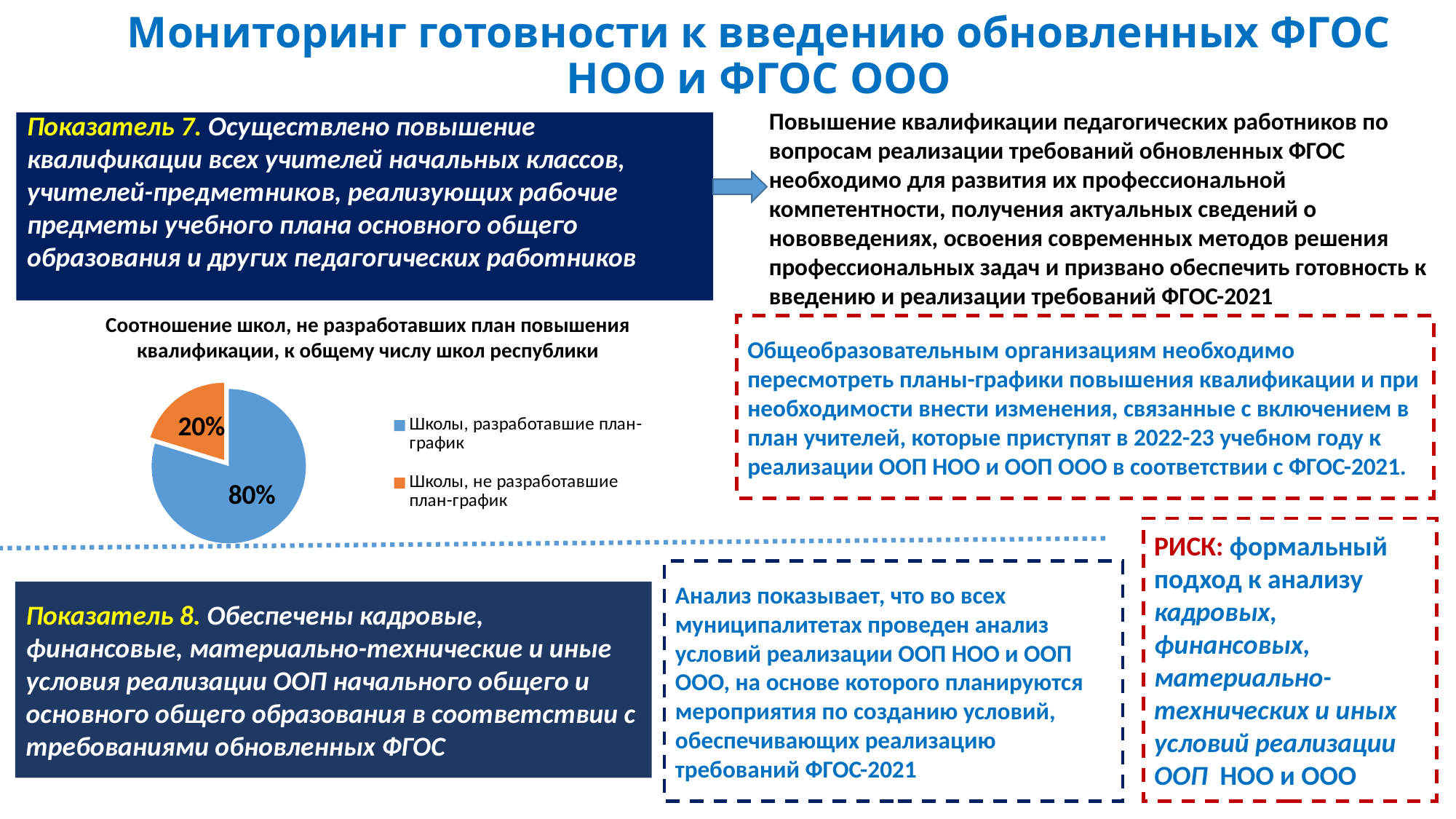
Which is larger: the share of schools that developed a plan-schedule or the share that did not? Школы, разработавшие план-график How many slices does the pie chart have? 2 What share of the pie is labelled "Школы, разработавшие план-график"? 80% How many entries does the legend of the pie chart list? 2 Which slice of the pie chart is the largest? Школы, разработавшие план-график What colour is the slice for "Школы, не разработавшие план-график"? orange What is the title of the pie chart? Соотношение школ, не разработавших план повышения квалификации, к общему числу школ республики Which slice of the pie chart is the smallest? Школы, не разработавшие план-график What share of the pie is labelled "Школы, не разработавшие план-график"? 20% What kind of chart is shown on the slide? pie chart What is the difference in percentage points between the two slices of the pie chart? 60